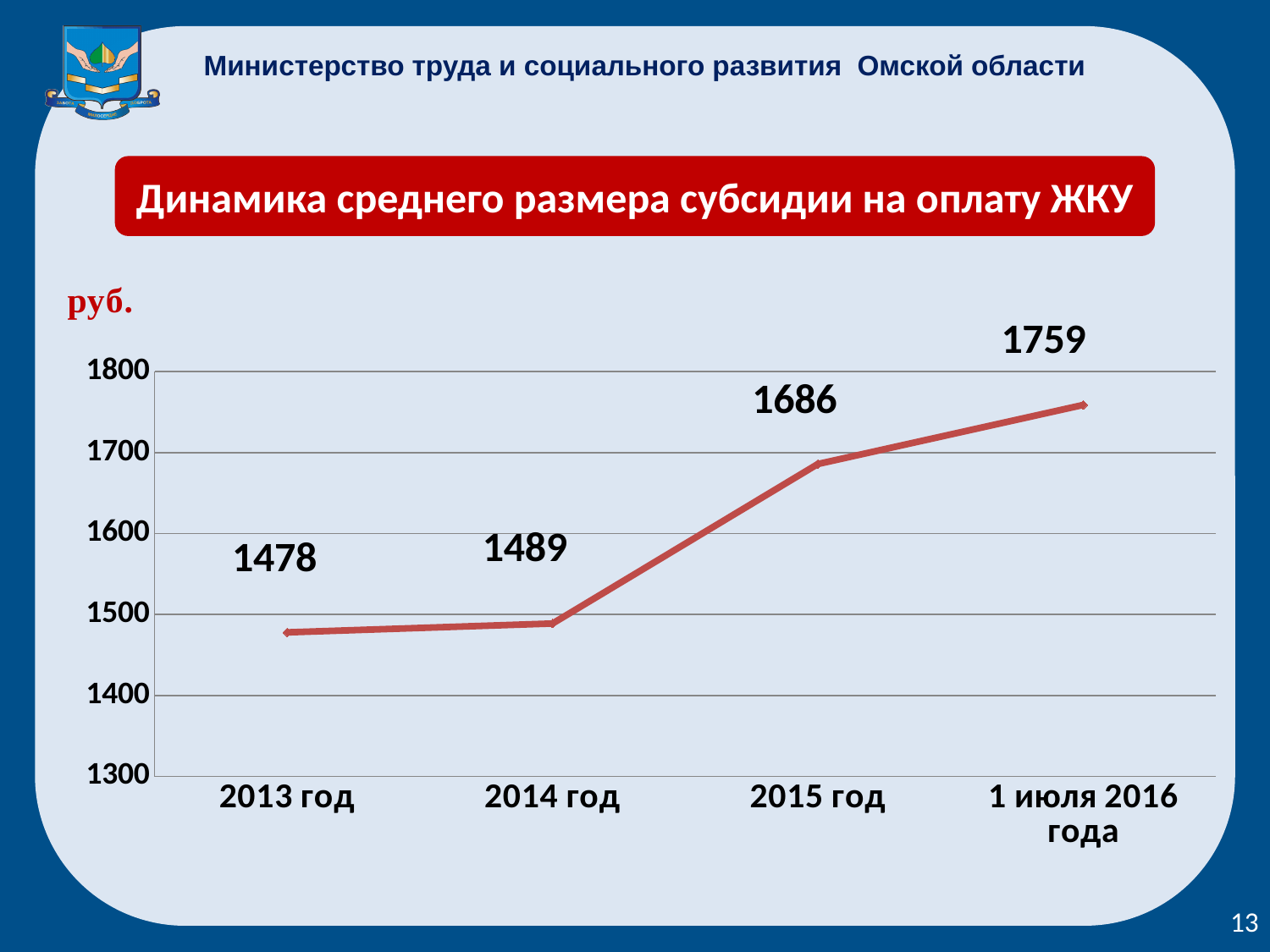
What is the average subsidy value for 2014 год? 1489 What is the average subsidy value for 2015 год? 1686 What is the difference between the values for 2015 год and 2014 год? 197 What is the average subsidy value for 1 июля 2016 года? 1759 Which period has the lowest average subsidy value? 2013 год What is the difference between the values for 1 июля 2016 года and 2015 год? 73 How many data points are plotted on the chart? 4 Do the values rise or fall from 2013 год to 1 июля 2016 года? rise What is the average subsidy value for 2013 год? 1478 Which period has the highest average subsidy value? 1 июля 2016 года What kind of chart is shown on the slide? line chart Which is larger, the value for 2015 год or the value for 2014 год? 2015 год